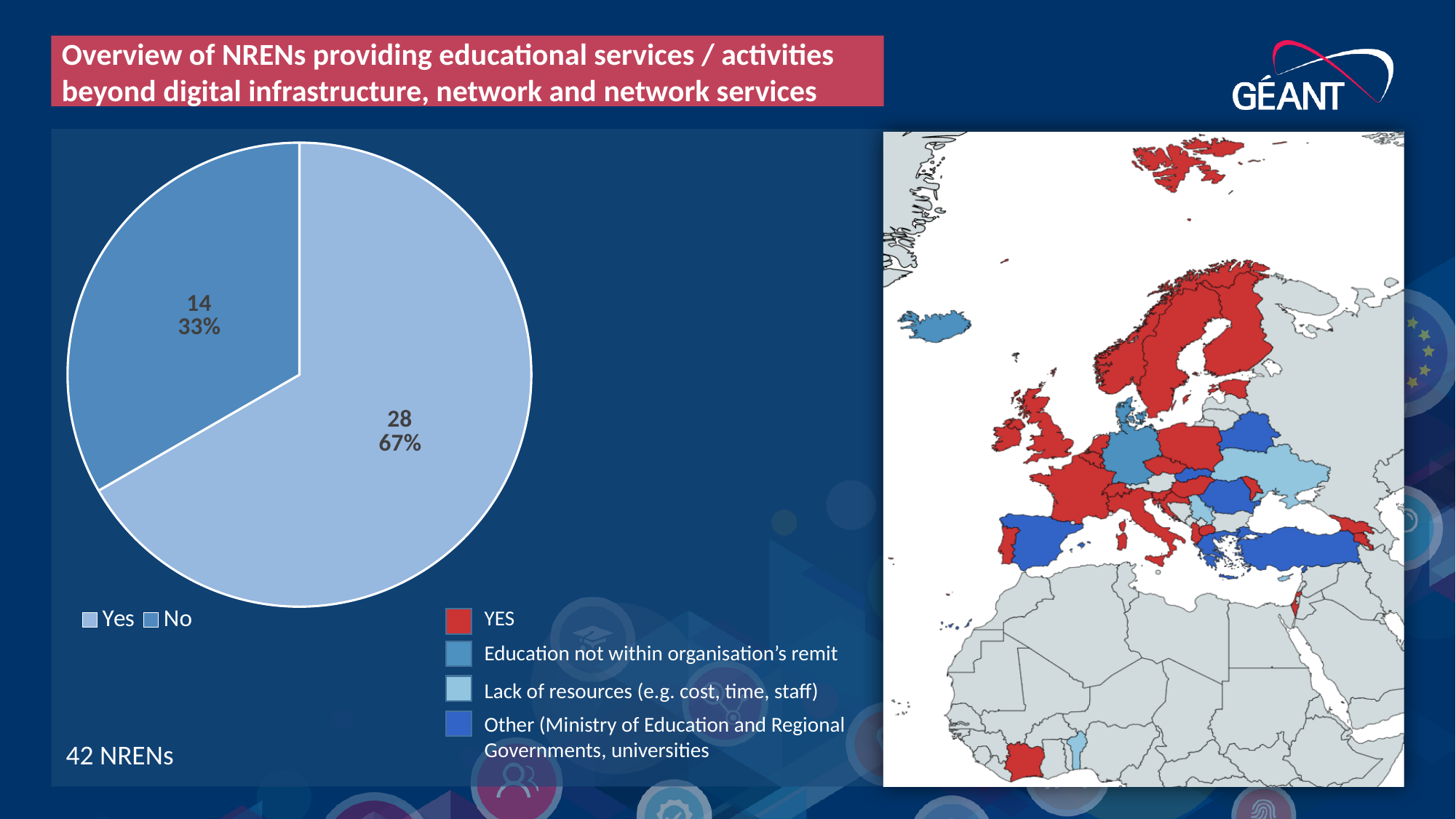
In the pie chart, which is larger, the Yes slice or the No slice? Yes In the pie chart, what percentage share does the Yes slice have? 67% How many slices does the pie chart have? 2 How many entries does the pie chart's legend list? 2 In the pie chart, how many NRENs answered No? 14 What kind of chart is shown on the left of the slide? pie chart In the pie chart, what is the difference between the number of Yes and No responses? 14 In the pie chart, how many NRENs answered Yes? 28 In the pie chart, which category has the smallest slice? No In the pie chart, what percentage share does the No slice have? 33% In the pie chart, which category has the largest slice? Yes What is the total number of NRENs represented in the pie chart? 42